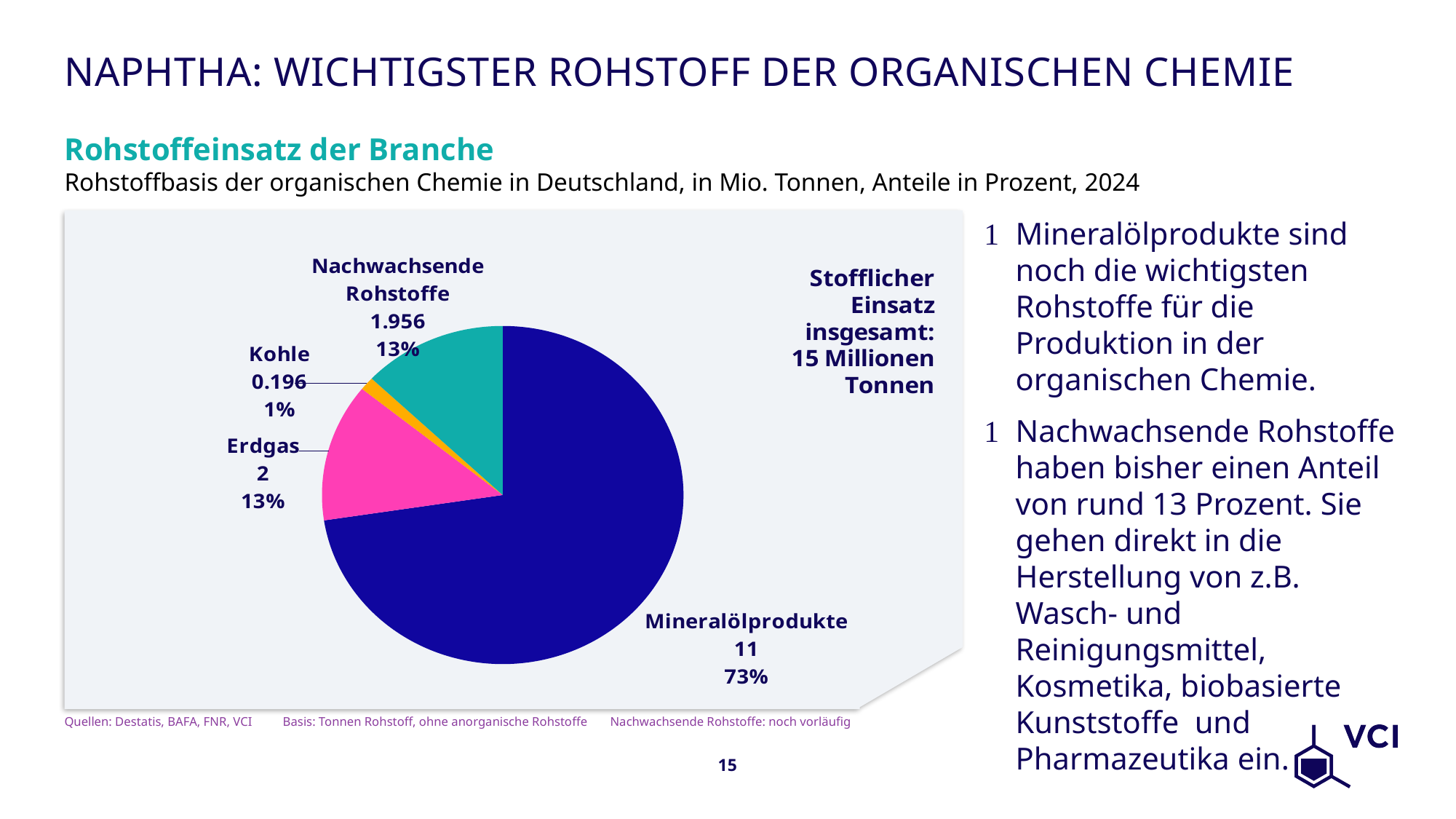
Which category has the largest slice in the pie chart? Mineralölprodukte What is the value shown for Nachwachsende Rohstoffe? 1.956 Which category has the smallest slice in the pie chart? Kohle What percentage share does Erdgas have in the pie chart? 13% What type of chart is shown on the slide? pie chart What is the value shown for Kohle? 0.196 Which is larger, the value for Erdgas or the value for Kohle? Erdgas What is the value shown for Mineralölprodukte in the pie chart? 11 How many slices does the pie chart have? 4 What is the difference between the value for Mineralölprodukte and the value for Erdgas? 9 According to the text in the chart, what is the total stofflicher Einsatz? 15 Millionen Tonnen What percentage share does Mineralölprodukte have in the pie chart? 73%